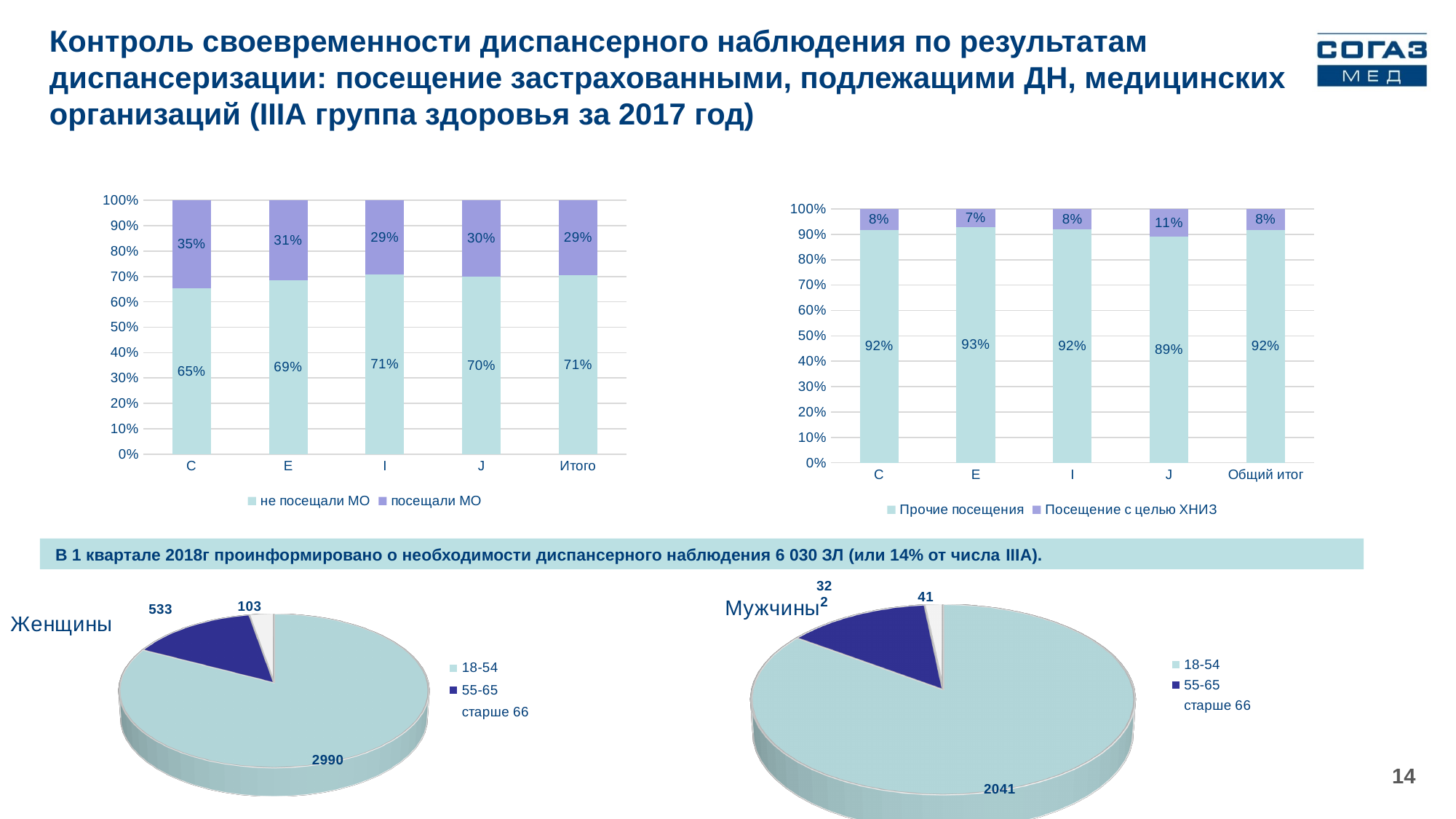
In the top-right bar chart, what is the value of 'Посещение с целью ХНИЗ' for category J? 11% In the top-right bar chart, which category has the lowest 'Прочие посещения' value? J In the top-left bar chart, which category has the highest 'посещали МО' value? C In the Мужчины pie chart, what is the value for the 18-54 group? 2041 In the Женщины pie chart, which age group has the smallest slice? старше 66 In the top-right bar chart, what is the value of 'Прочие посещения' for Общий итог? 92% In the top-right bar chart, how many series does the legend list? 2 In the top-left bar chart, what is the value of 'посещали МО' for Итого? 29% In the top-left bar chart, what is the difference between the 'не посещали МО' values for I and C? 6% In the top-left bar chart, what is the value of 'не посещали МО' for category C? 65% In the Женщины pie chart, what is the value for the 18-54 group? 2990 What kind of chart is the bottom-left chart labelled Женщины? Pie chart